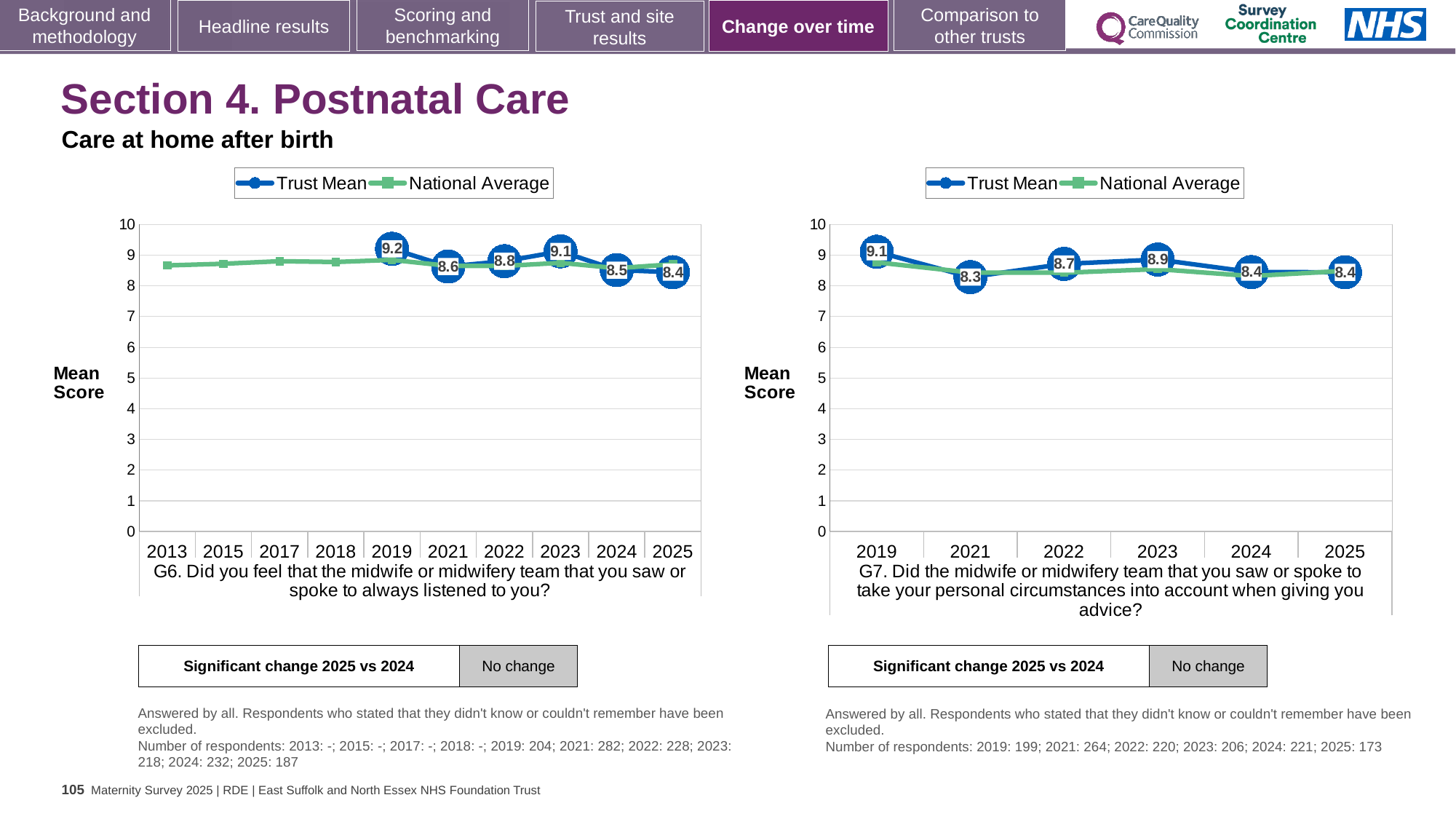
What type of chart is the right chart (G7)? Line chart In the left chart (G6), is the National Average for 2013 greater or less than 8? greater In the right chart (G7), which year has the highest Trust Mean? 2019 In the left chart (G6), what is the Trust Mean for 2025? 8.4 In the right chart (G7), what is the difference between the Trust Mean in 2023 and in 2024? 0.5 In the left chart (G6), which year has the lowest labelled Trust Mean? 2025 In the left chart (G6), what is the difference between the Trust Mean in 2019 and in 2025? 0.8 How many years are shown on the x axis of the left chart (G6)? 10 How many series does the legend of the right chart (G7) list? 2 In the right chart (G7), which is larger: the Trust Mean for 2022 or for 2021? 2022 In the left chart (G6), what is the Trust Mean for 2019? 9.2 In the right chart (G7), what is the Trust Mean for 2021? 8.3